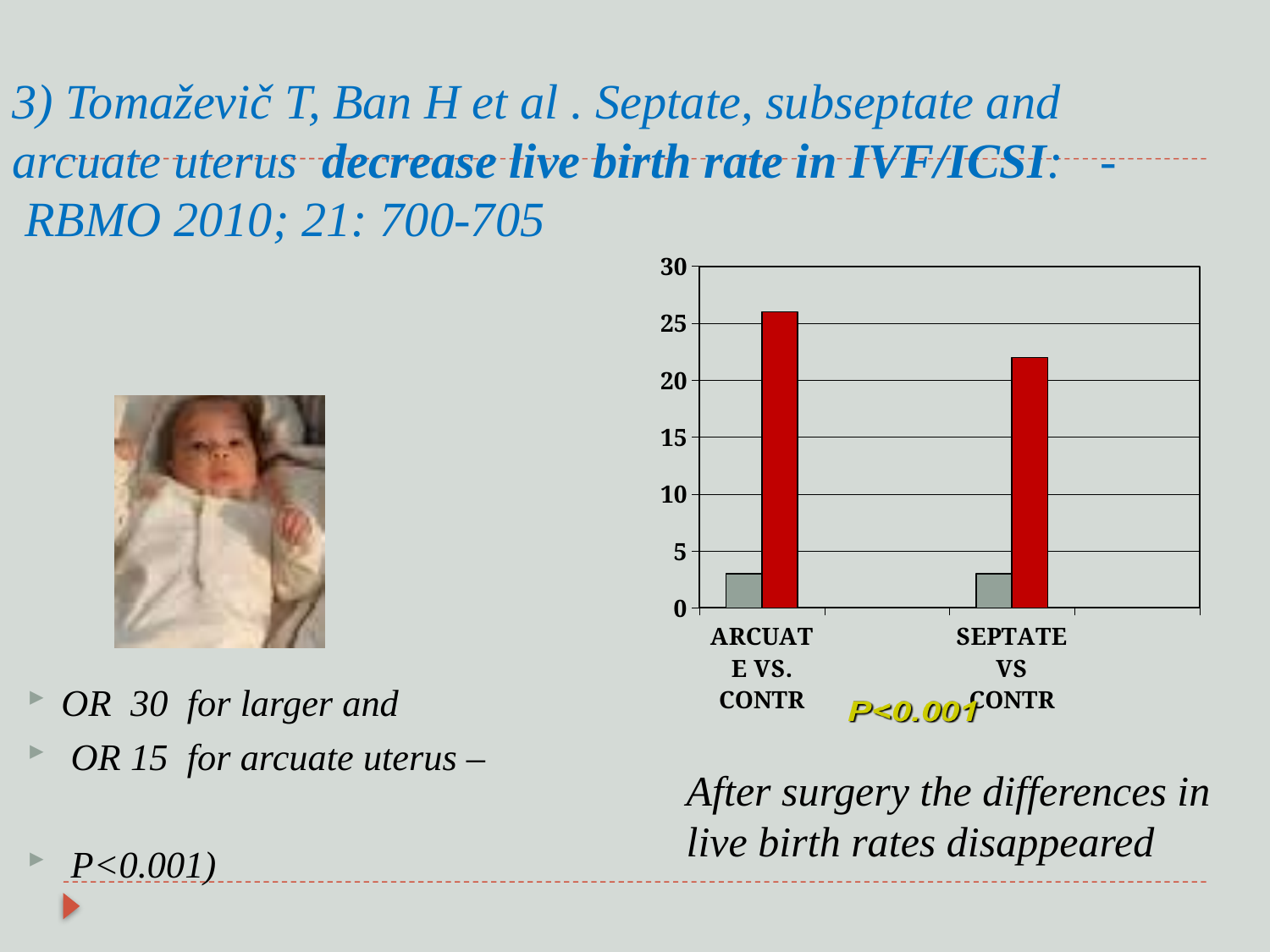
Within the ARCUATE VS. CONTR category, which bar is taller, the grey bar or the red bar? the red bar What kind of chart is shown on the slide? bar chart Is the value of the red bar for ARCUATE VS. CONTR greater or less than 20? greater What is the highest value shown on the vertical axis of the chart? 30 Is the value of the grey bar for ARCUATE VS. CONTR greater or less than 5? less Which category has the taller red bar, ARCUATE VS. CONTR or SEPTATE VS CONTR? ARCUATE VS. CONTR How many categories are shown on the x axis of the chart? 2 Is the value of the red bar for SEPTATE VS CONTR greater or less than 25? less How many bars are plotted for each category in the chart? 2